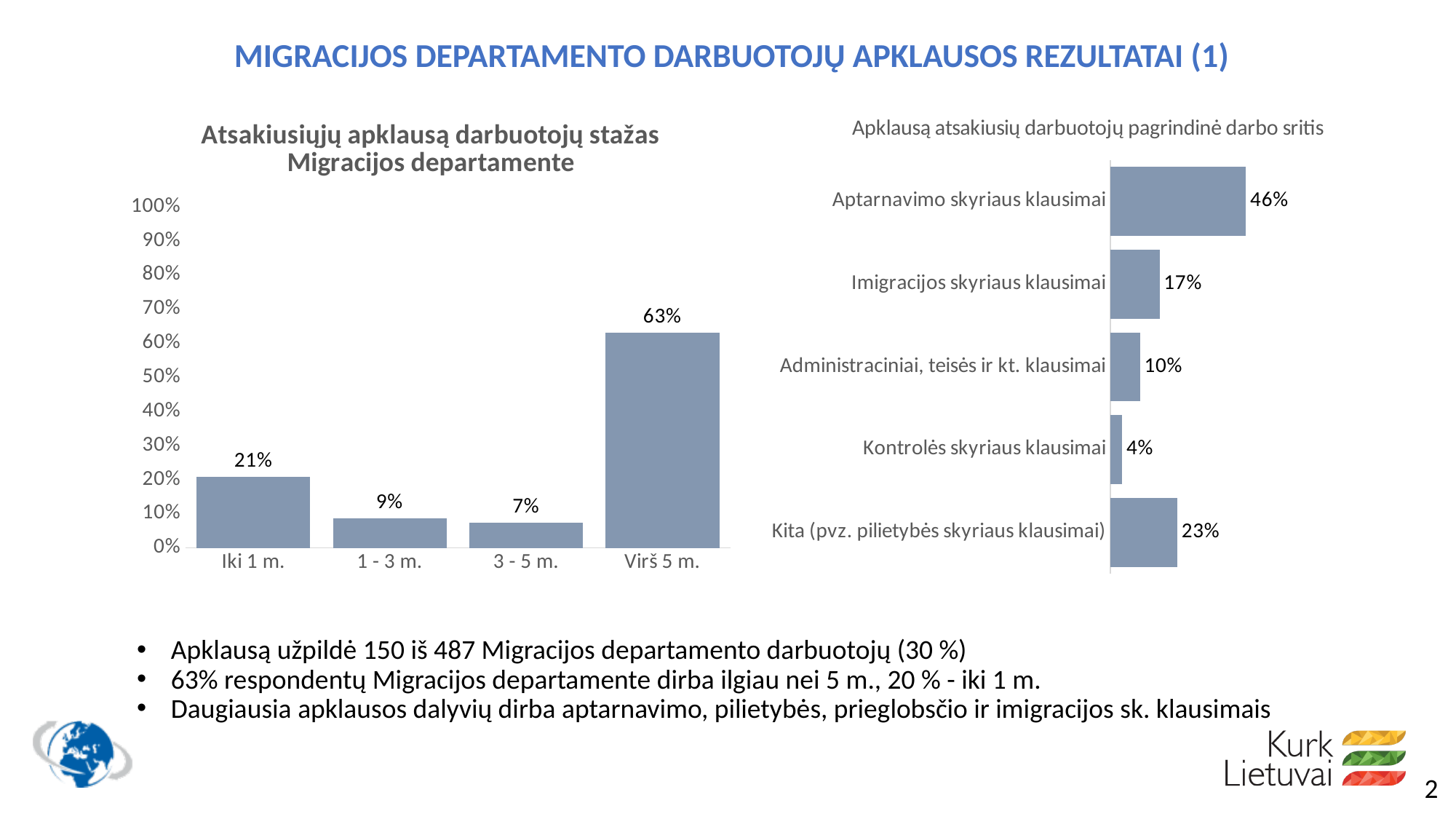
In the right chart 'Apklausą atsakiusių darbuotojų pagrindinė darbo sritis', what is the difference between 'Aptarnavimo skyriaus klausimai' and 'Kita (pvz. pilietybės skyriaus klausimai)'? 23% In the right chart 'Apklausą atsakiusių darbuotojų pagrindinė darbo sritis', which category has the highest value? Aptarnavimo skyriaus klausimai In the left chart 'Atsakiusiųjų apklausą darbuotojų stažas Migracijos departamente', how many categories are shown on the x axis? 4 In the left chart 'Atsakiusiųjų apklausą darbuotojų stažas Migracijos departamente', what is the value for 'Virš 5 m.'? 63% In the left chart 'Atsakiusiųjų apklausą darbuotojų stažas Migracijos departamente', what kind of chart is it? Bar chart In the right chart 'Apklausą atsakiusių darbuotojų pagrindinė darbo sritis', how many categories are shown? 5 In the left chart 'Atsakiusiųjų apklausą darbuotojų stažas Migracijos departamente', what is the difference between 'Virš 5 m.' and 'Iki 1 m.'? 42% In the right chart 'Apklausą atsakiusių darbuotojų pagrindinė darbo sritis', what is the value for 'Kontrolės skyriaus klausimai'? 4% In the right chart 'Apklausą atsakiusių darbuotojų pagrindinė darbo sritis', what is the value for 'Imigracijos skyriaus klausimai'? 17% In the right chart 'Apklausą atsakiusių darbuotojų pagrindinė darbo sritis', which is larger: 'Kita (pvz. pilietybės skyriaus klausimai)' or 'Administraciniai, teisės ir kt. klausimai'? Kita (pvz. pilietybės skyriaus klausimai) In the left chart 'Atsakiusiųjų apklausą darbuotojų stažas Migracijos departamente', what is the value for '1 - 3 m.'? 9% In the left chart 'Atsakiusiųjų apklausą darbuotojų stažas Migracijos departamente', which category has the lowest value? 3 - 5 m.